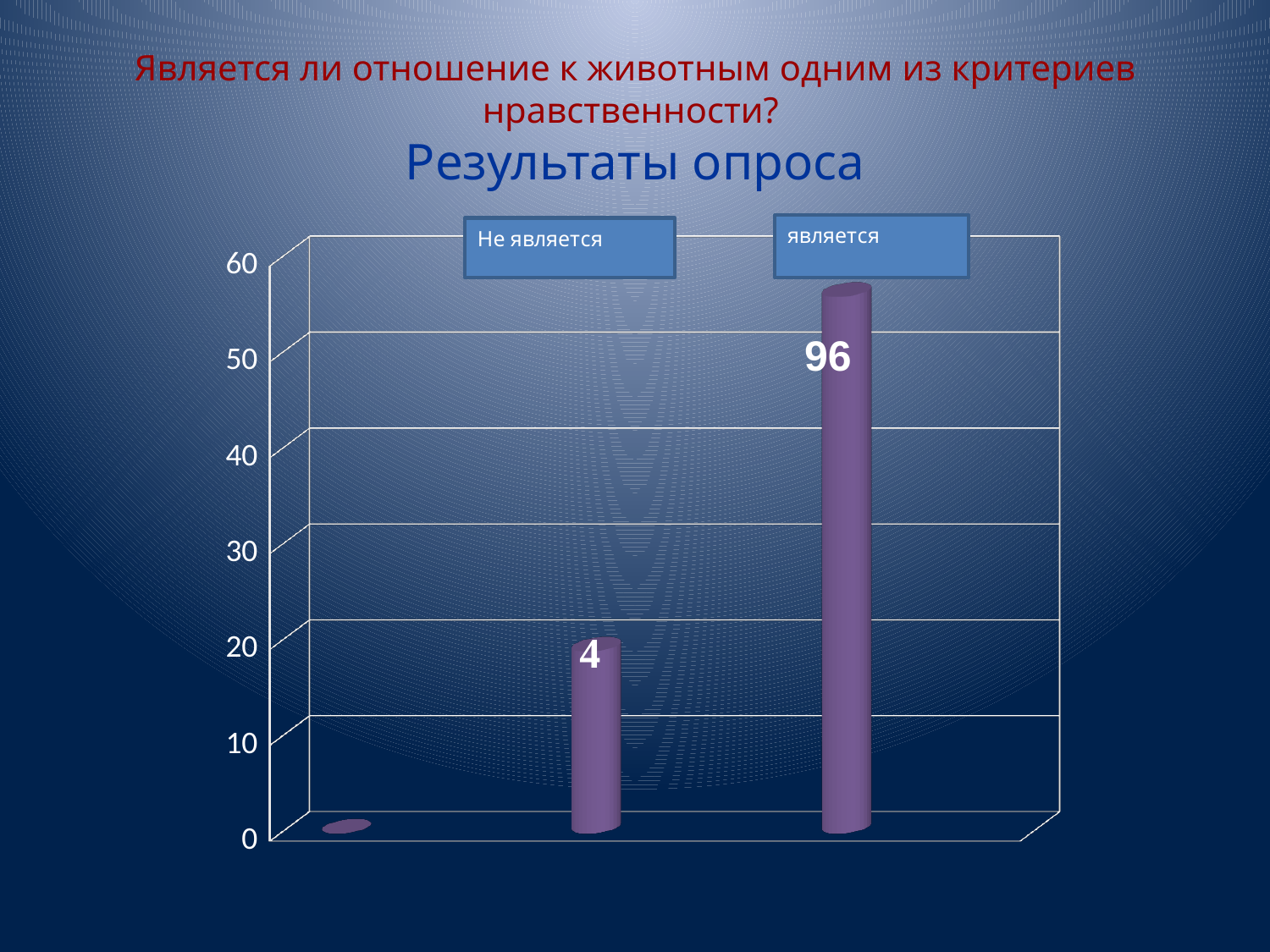
What is the difference between the values for "является" and "Не является"? 92 What is the highest value shown on the vertical axis? 60 What is the title of the chart? Результаты опроса What value is shown for the bar labelled "является"? 96 What kind of chart is shown on the slide? Bar chart Which category has the lowest value? Не является What colour are the bars in the chart? Purple What value is shown for the bar labelled "Не является"? 4 Which is larger: the value for "является" or the value for "Не является"? является What is the sum of the two labelled values, 4 and 96? 100 Which category has the highest value? является